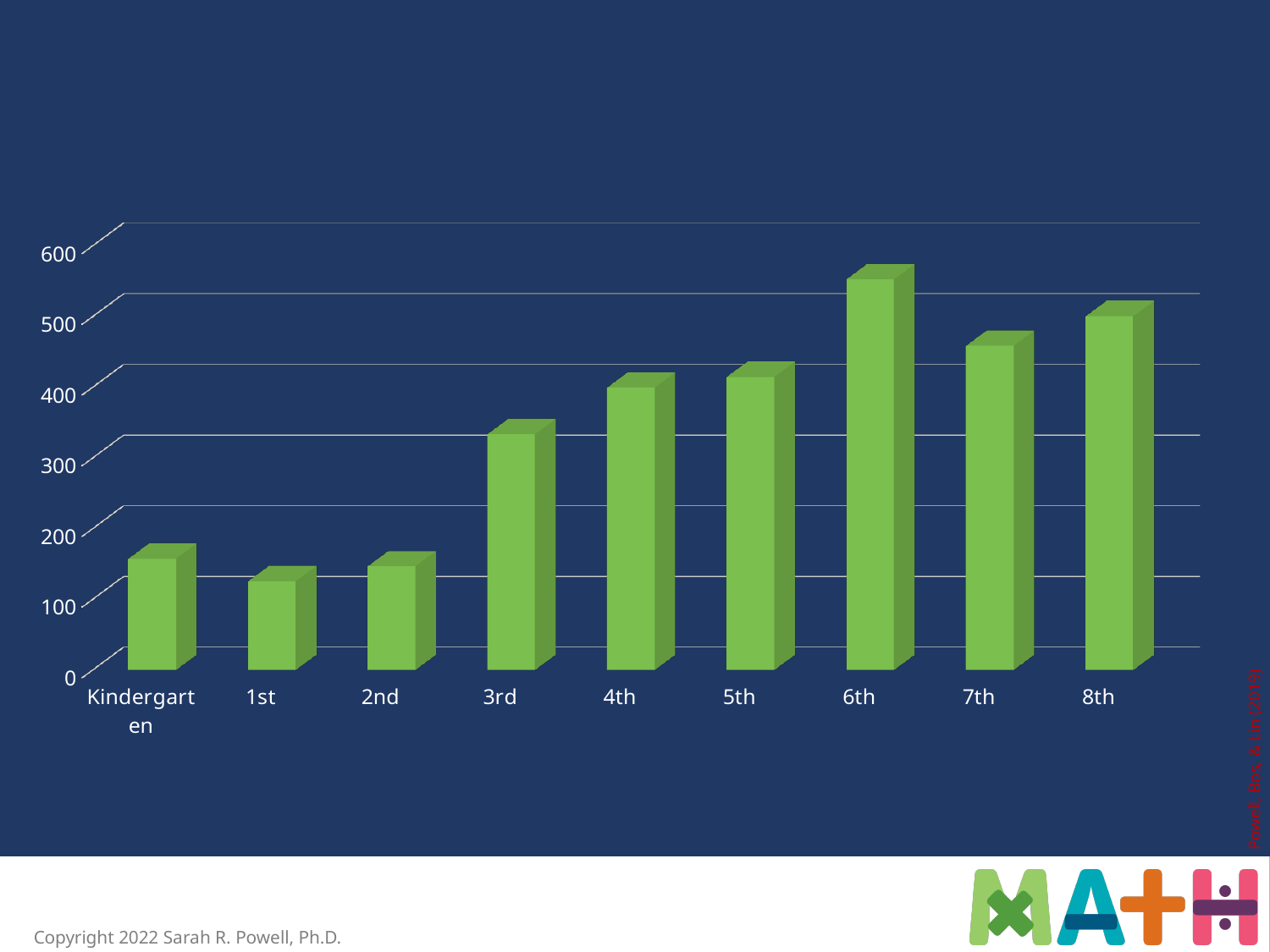
Is the value for Kindergarten greater or less than 200? less Which grade has the highest bar? 6th Is the value for 6th grade greater or less than 500? greater What kind of chart is shown on the slide? bar chart How many grade categories are shown on the x axis? 9 Is the value for 7th grade greater or less than 400? greater What colour are the bars in the chart? green Which grade has the lowest bar? 1st Which is larger, the value for 6th grade or the value for 7th grade? 6th Which is larger, the value for 2nd grade or the value for 3rd grade? 3rd